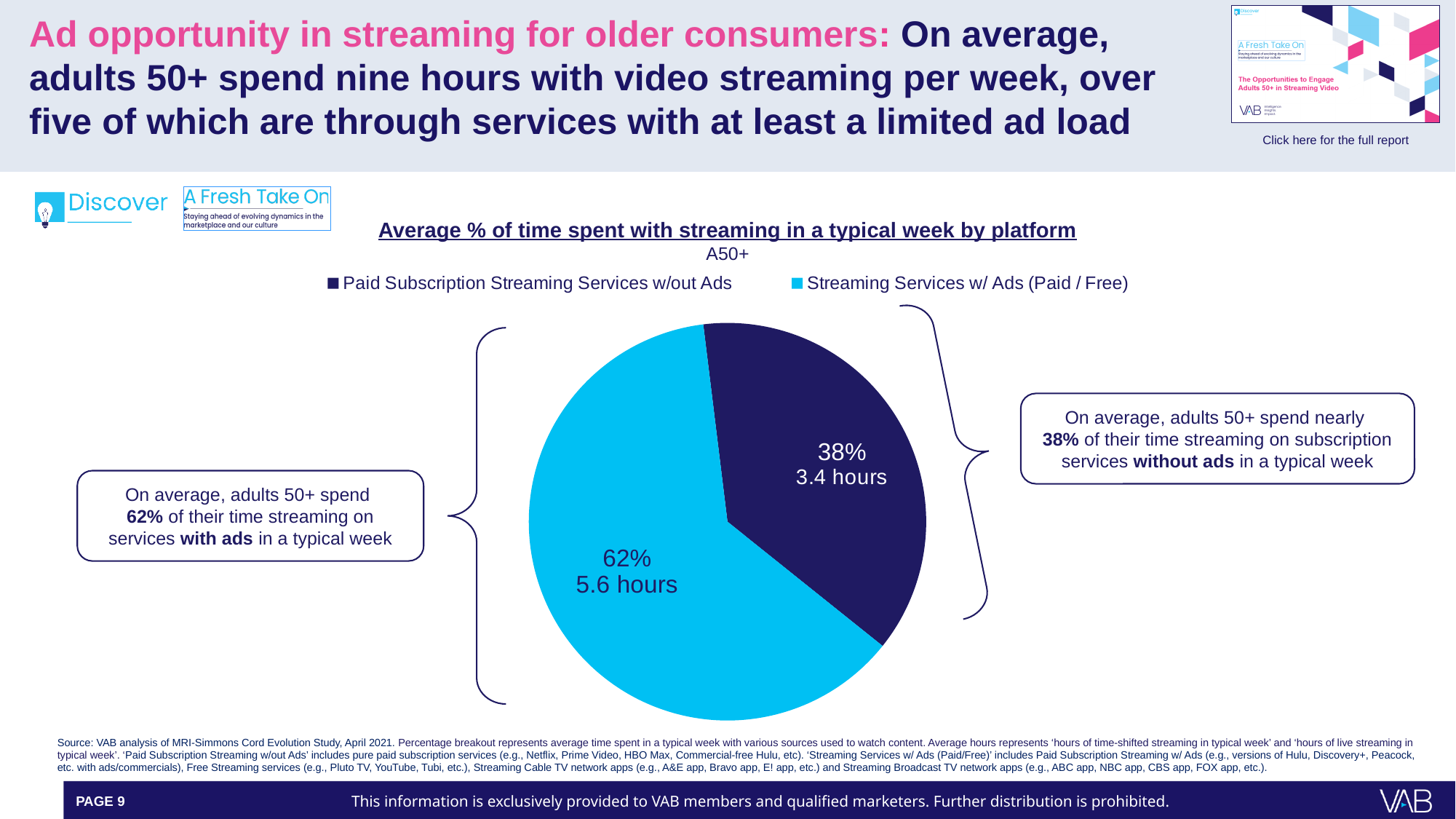
Which platform category has the smallest share of streaming time? Paid Subscription Streaming Services w/out Ads What percentage of streaming time do adults 50+ spend on Paid Subscription Streaming Services w/out Ads? 38% Which platform category has the largest share of streaming time? Streaming Services w/ Ads (Paid / Free) How many slices does the pie chart have? 2 What is the title of the chart? Average % of time spent with streaming in a typical week by platform Which is larger: the hours spent on Streaming Services w/ Ads or on Paid Subscription Streaming Services w/out Ads? Streaming Services w/ Ads What percentage of streaming time do adults 50+ spend on Streaming Services w/ Ads (Paid / Free)? 62% How many hours per week do adults 50+ spend on Paid Subscription Streaming Services w/out Ads? 3.4 hours How many entries does the legend list? 2 What is the difference in percentage points between the share for Streaming Services w/ Ads and the share for Paid Subscription Streaming Services w/out Ads? 24 percentage points What kind of chart is shown on the slide? Pie chart How many hours per week do adults 50+ spend on Streaming Services w/ Ads (Paid / Free)? 5.6 hours